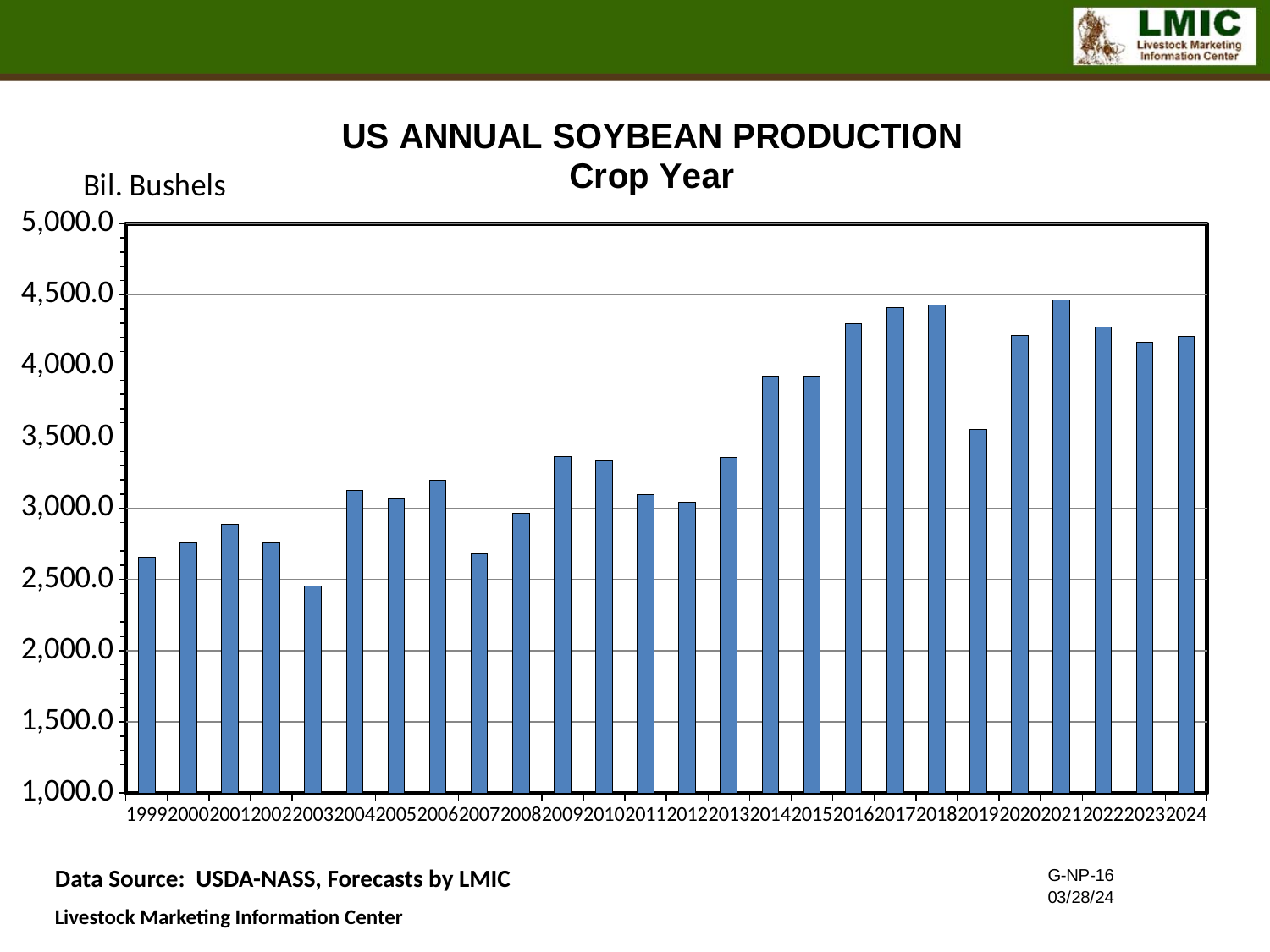
How many crop years are plotted in the chart? 26 Is the value for 2016 greater or less than 4,000.0? greater Overall, do soybean production values rise or fall from 1999 to 2024? rise Which crop year has the lowest soybean production in the chart? 2003 Which crop year has the larger soybean production, 2019 or 2020? 2020 Is the value for 2003 greater or less than 2,500.0? less Which crop year has the larger soybean production, 2009 or 2012? 2009 Is the value for 2019 greater or less than 3,500.0? greater What unit is shown on the vertical axis of the chart? Bil. Bushels Which crop year has the highest soybean production in the chart? 2021 What kind of chart is shown on the slide? bar chart